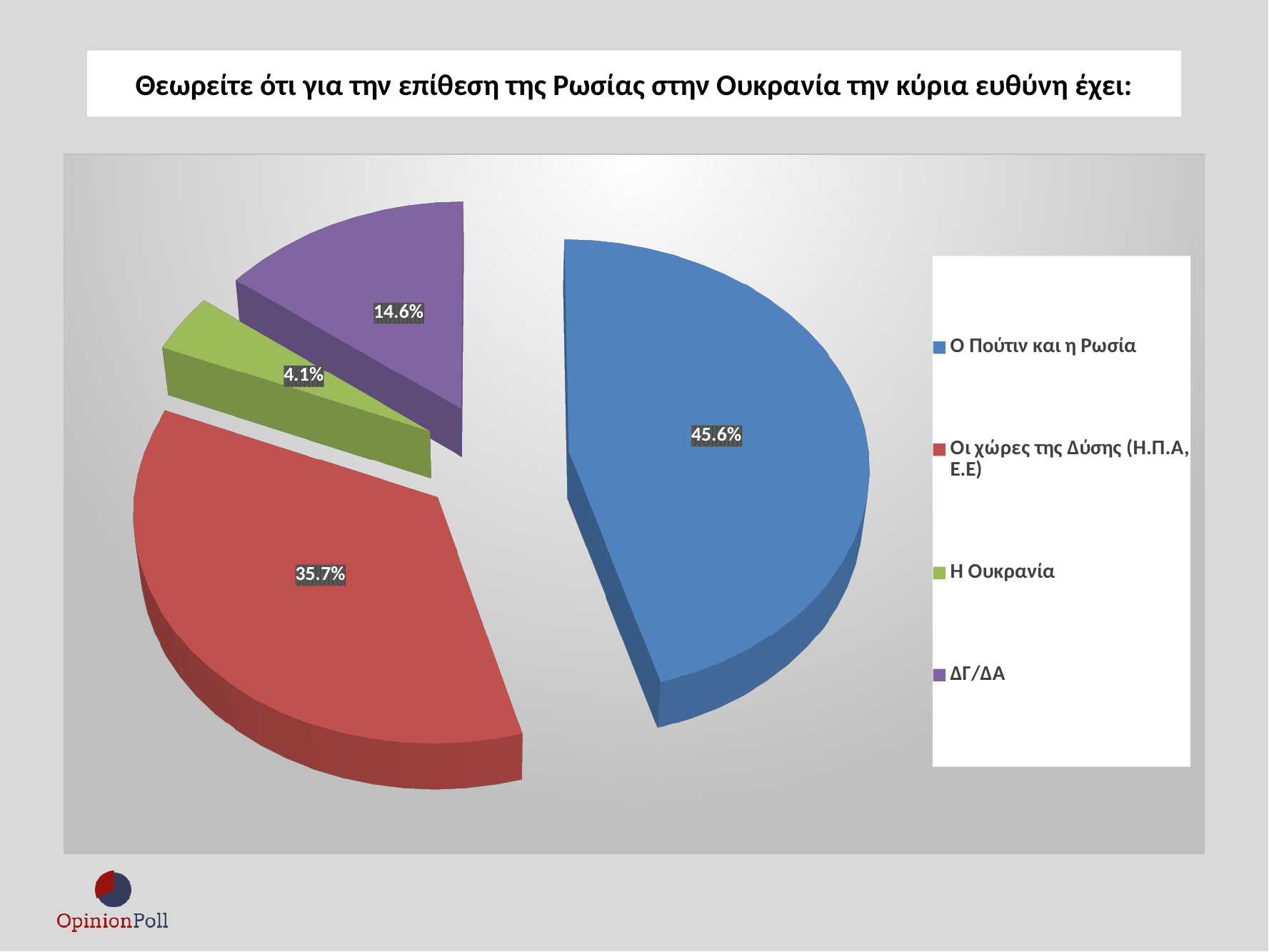
Which category has the largest slice of the pie? Ο Πούτιν και η Ρωσία What is the difference in percentage points between Ο Πούτιν και η Ρωσία and Οι χώρες της Δύσης (Η.Π.Α, Ε.Ε)? 9.9 What percentage is shown for ΔΓ/ΔΑ? 14.6% What kind of chart is shown on the slide? pie chart What percentage is shown for Η Ουκρανία? 4.1% What colour is the slice for Οι χώρες της Δύσης (Η.Π.Α, Ε.Ε)? red Which category has the smallest slice of the pie? Η Ουκρανία What is the difference in percentage points between ΔΓ/ΔΑ and Η Ουκρανία? 10.5 How many slices does the pie chart have? 4 What percentage is shown for Οι χώρες της Δύσης (Η.Π.Α, Ε.Ε)? 35.7% Which is larger: the slice for ΔΓ/ΔΑ or the slice for Η Ουκρανία? ΔΓ/ΔΑ What percentage is shown for Ο Πούτιν και η Ρωσία? 45.6%